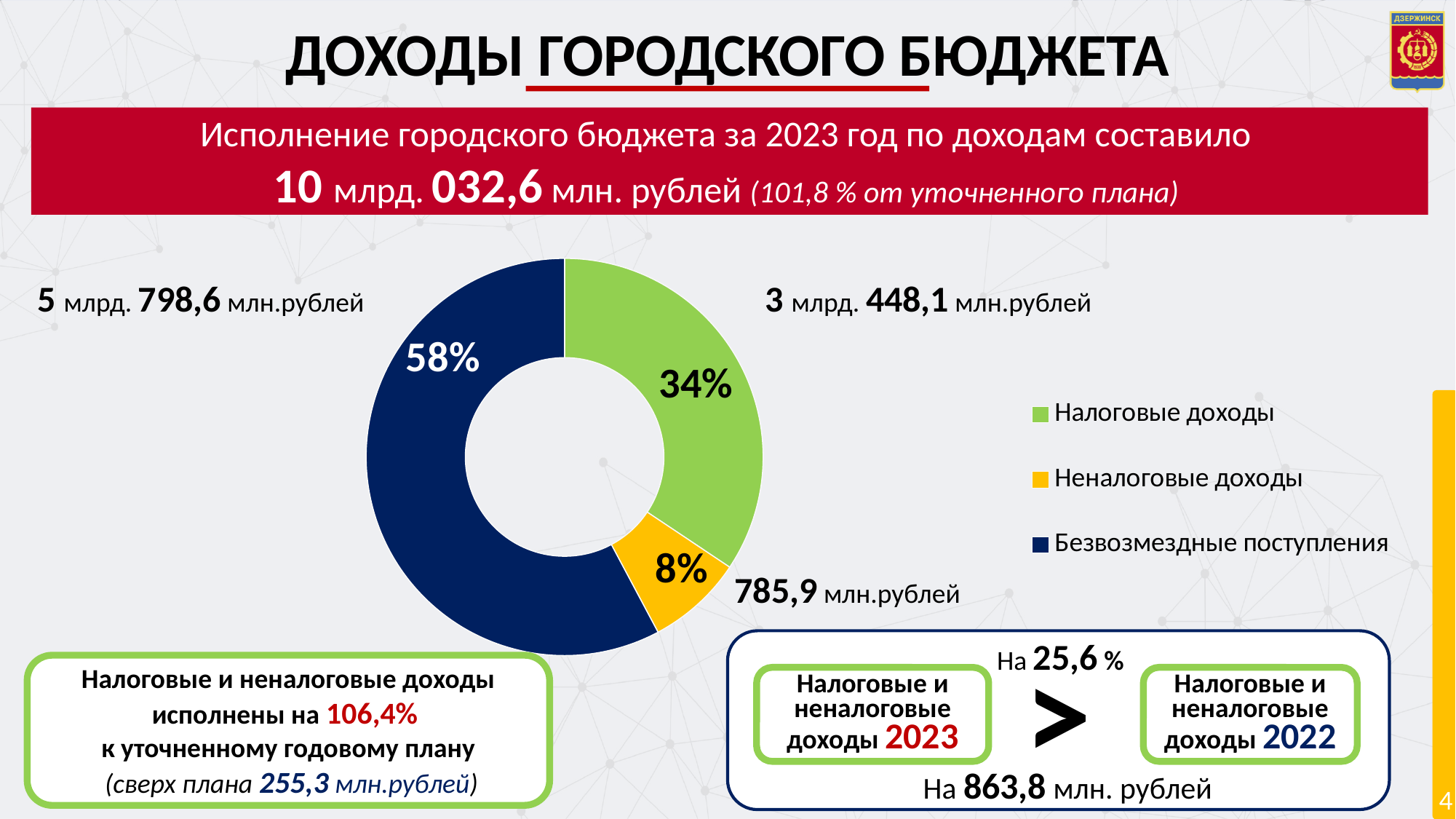
What share of the pie chart does Налоговые доходы represent? 34% What amount is shown for Налоговые доходы on the chart? 3 млрд. 448,1 млн.рублей What share of the pie chart does Безвозмездные поступления represent? 58% How many categories does the pie chart show? 3 What kind of chart is shown on the slide? doughnut chart What share of the pie chart does Неналоговые доходы represent? 8% What amount is shown for Безвозмездные поступления on the chart? 5 млрд. 798,6 млн.рублей By how many percentage points does the share of Безвозмездные поступления exceed the share of Налоговые доходы? 24% Which category has the largest share of the pie chart? Безвозмездные поступления Which category has the smallest share of the pie chart? Неналоговые доходы What amount is shown for Неналоговые доходы on the chart? 785,9 млн.рублей Which is larger: the share of Налоговые доходы or the share of Неналоговые доходы? Налоговые доходы